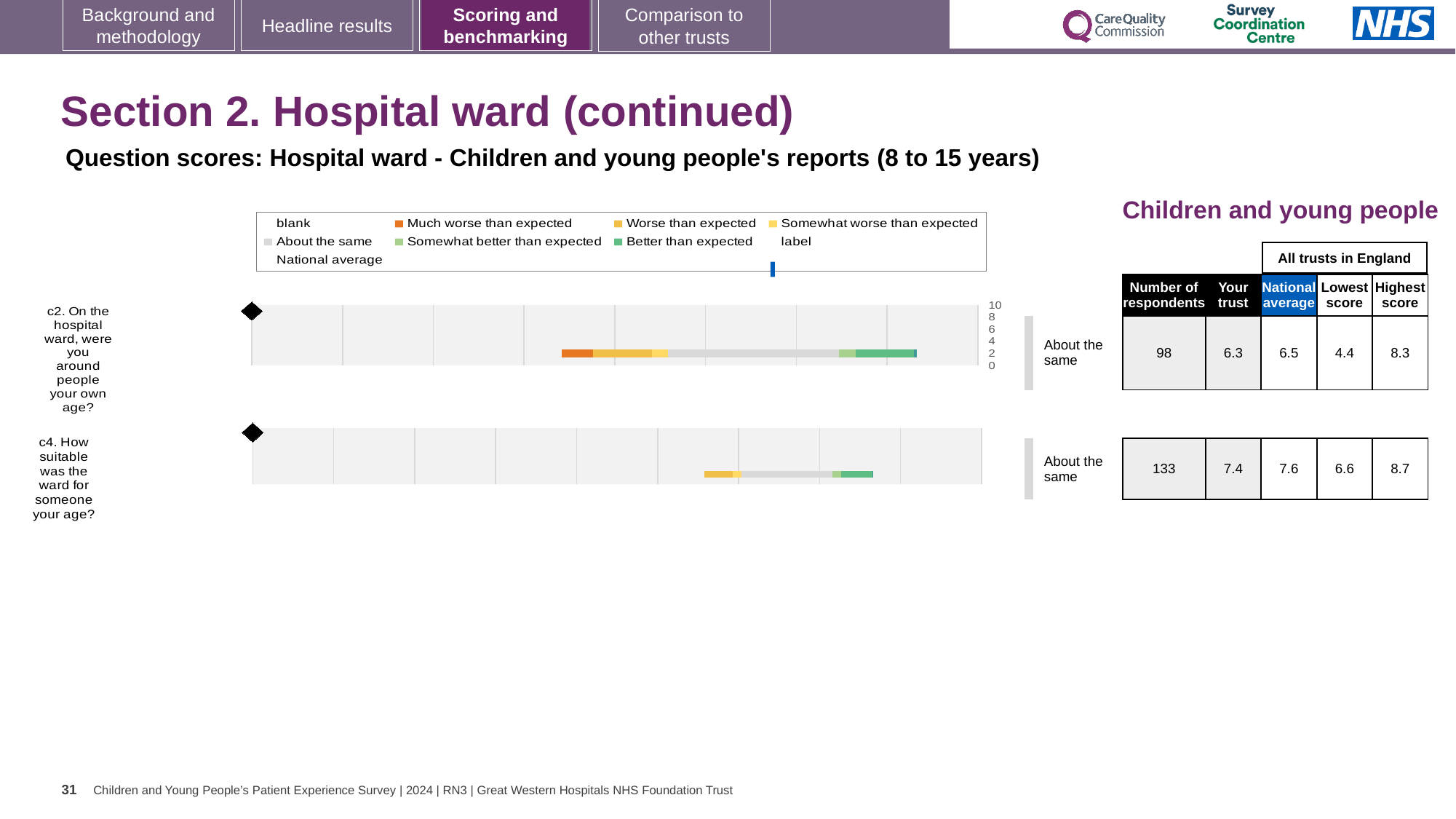
What is the 'Your trust' score for question c2 (On the hospital ward, were you around people your own age?)? 6.3 Which legend entry is shown in orange on the chart? Much worse than expected What is the national average score for question c2? 6.5 What is the 'Your trust' score for question c4 (How suitable was the ward for someone your age?)? 7.4 What is the difference between the national average and the 'Your trust' score for question c4? 0.2 How many respondents answered question c4? 133 What kind of chart is used to show the question scores on this slide? Bar chart How many survey questions are plotted on the slide's charts? 2 What is the difference between the highest and lowest scores across all trusts in England for question c2? 3.9 What benchmark category is shown for question c2? About the same Which question has the higher 'Your trust' score, c2 or c4? c4 What is the highest score among all trusts in England for question c4? 8.7